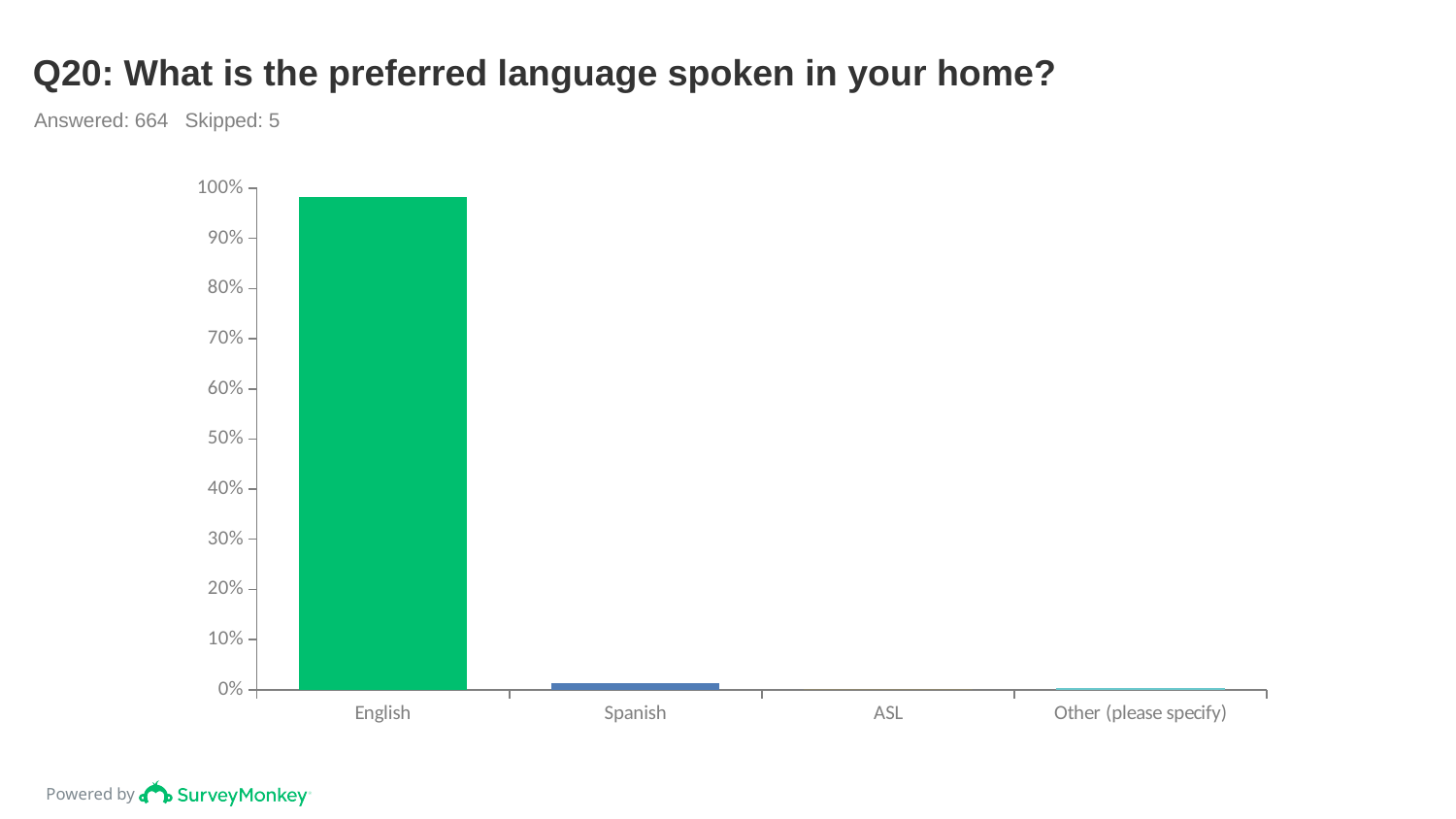
Is the value for Other (please specify) greater or less than 10%? less How many respondents answered the question shown on the slide? 664 Is the value for English greater or less than 90%? greater Which category has the highest value in the chart? English What kind of chart is shown on the slide? bar chart Is the value for Spanish greater or less than 10%? less Which is larger, the value for Spanish or the value for ASL? Spanish How many categories are shown on the x axis of the chart? 4 What is the title of the chart on the slide? Q20: What is the preferred language spoken in your home? Which is larger, the value for English or the value for Spanish? English